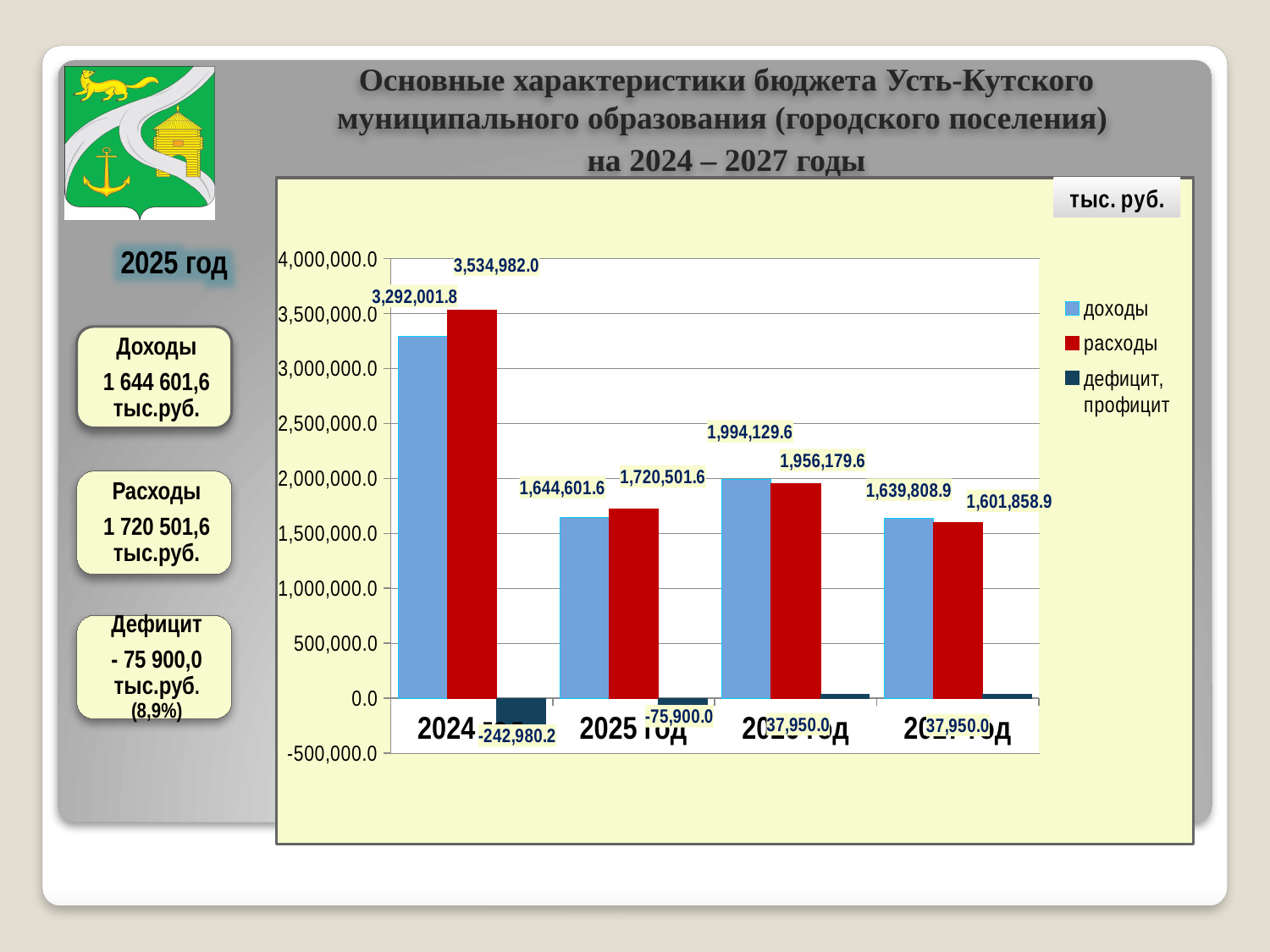
What is the value of расходы for 2025 год? 1,720,501.6 Which year has the lowest value of доходы? 2027 год What is the value of доходы for 2024 год? 3,292,001.8 How many series does the chart legend list? 3 What is the difference between расходы and доходы for 2025 год? 75,900.0 What kind of chart is shown on the slide? bar chart Is the value of доходы for 2024 год greater or less than 3,000,000.0? greater Which year has the highest value of расходы? 2024 год For 2024 год, which is larger: доходы or расходы? расходы What is the value of доходы for 2025 год? 1,644,601.6 How many years are shown on the x axis of the chart? 4 What is the value of дефицит, профицит for 2024 год? -242,980.2